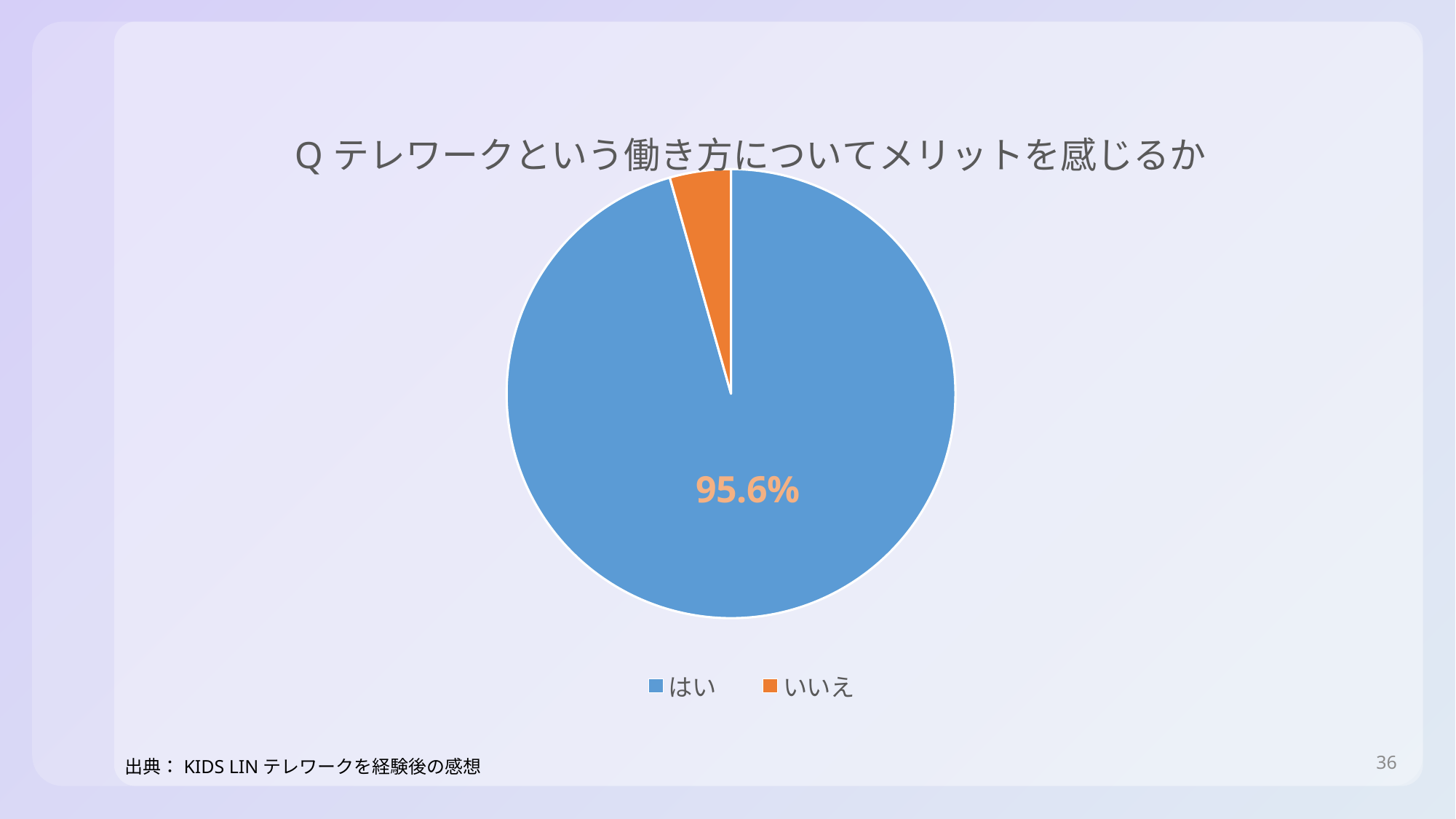
Which colour represents いいえ in the pie chart? Orange Which category has the smallest slice in the pie chart? いいえ How many categories are shown in the pie chart? 2 What share of the pie does the はい slice represent? 95.6% What kind of chart is shown on the slide? Pie chart How many entries does the legend list? 2 Which is larger, the はい slice or the いいえ slice? はい What is the title of the chart? Q テレワークという働き方についてメリットを感じるか What percentage is shown for the はい slice of the pie chart? 95.6% Which category has the largest slice in the pie chart? はい